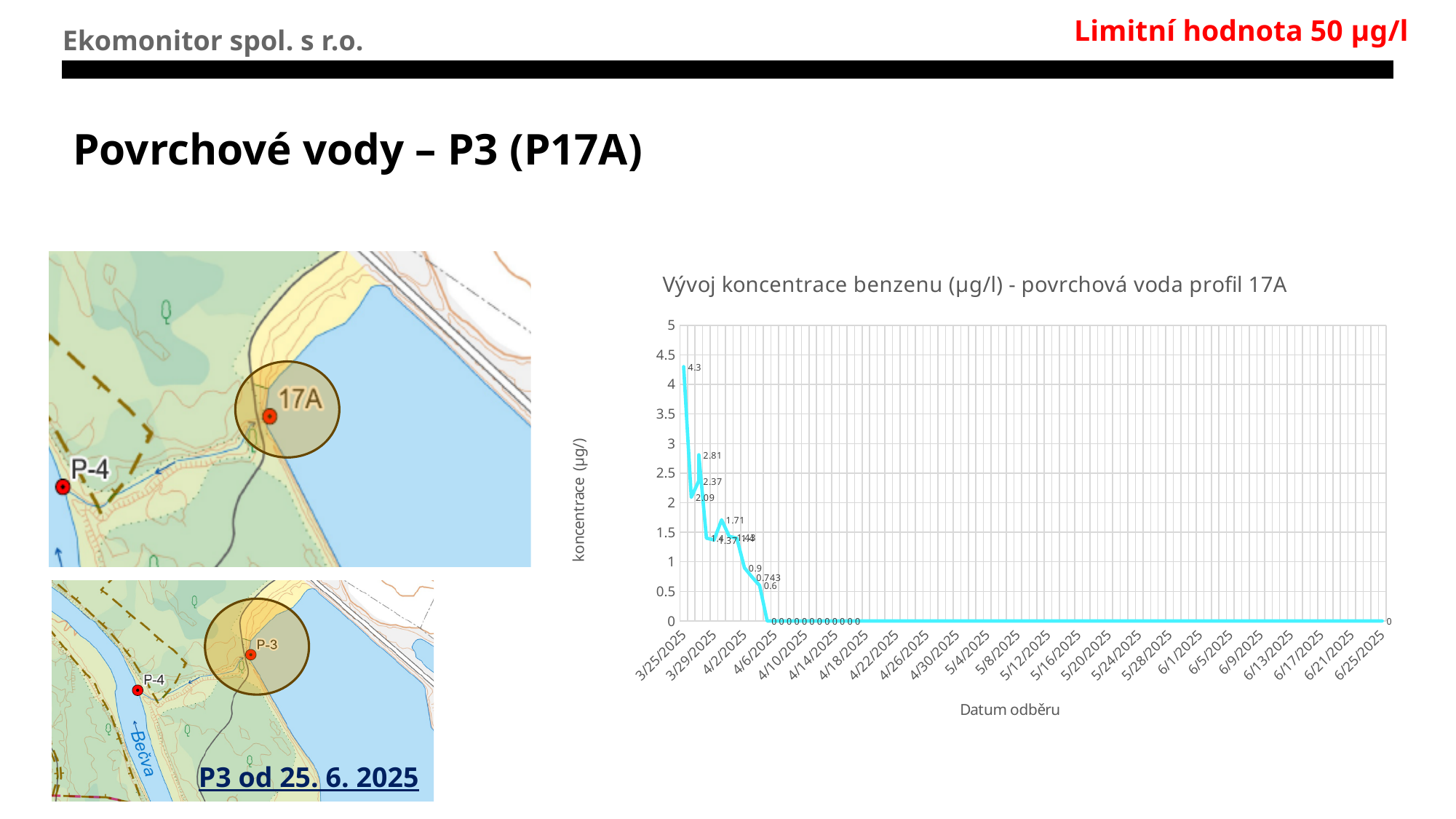
What is the benzene concentration value plotted for 6/25/2025? 0 What is the benzene concentration value plotted for 3/25/2025? 4.3 What is the highest benzene concentration value plotted on the chart? 4.3 What kind of chart is shown on the slide? line chart What is the difference between the highest labelled value (4.3) and the second-highest labelled value (2.81)? 1.49 What is the title of the chart? Vývoj koncentrace benzenu (µg/l) - povrchová voda profil 17A What is the lowest benzene concentration value plotted on the chart? 0 Do the benzene concentration values rise or fall over time along the x axis? fall What is the label of the vertical axis? koncentrace (µg/l) Is the value for 3/25/2025 greater or less than 4? greater